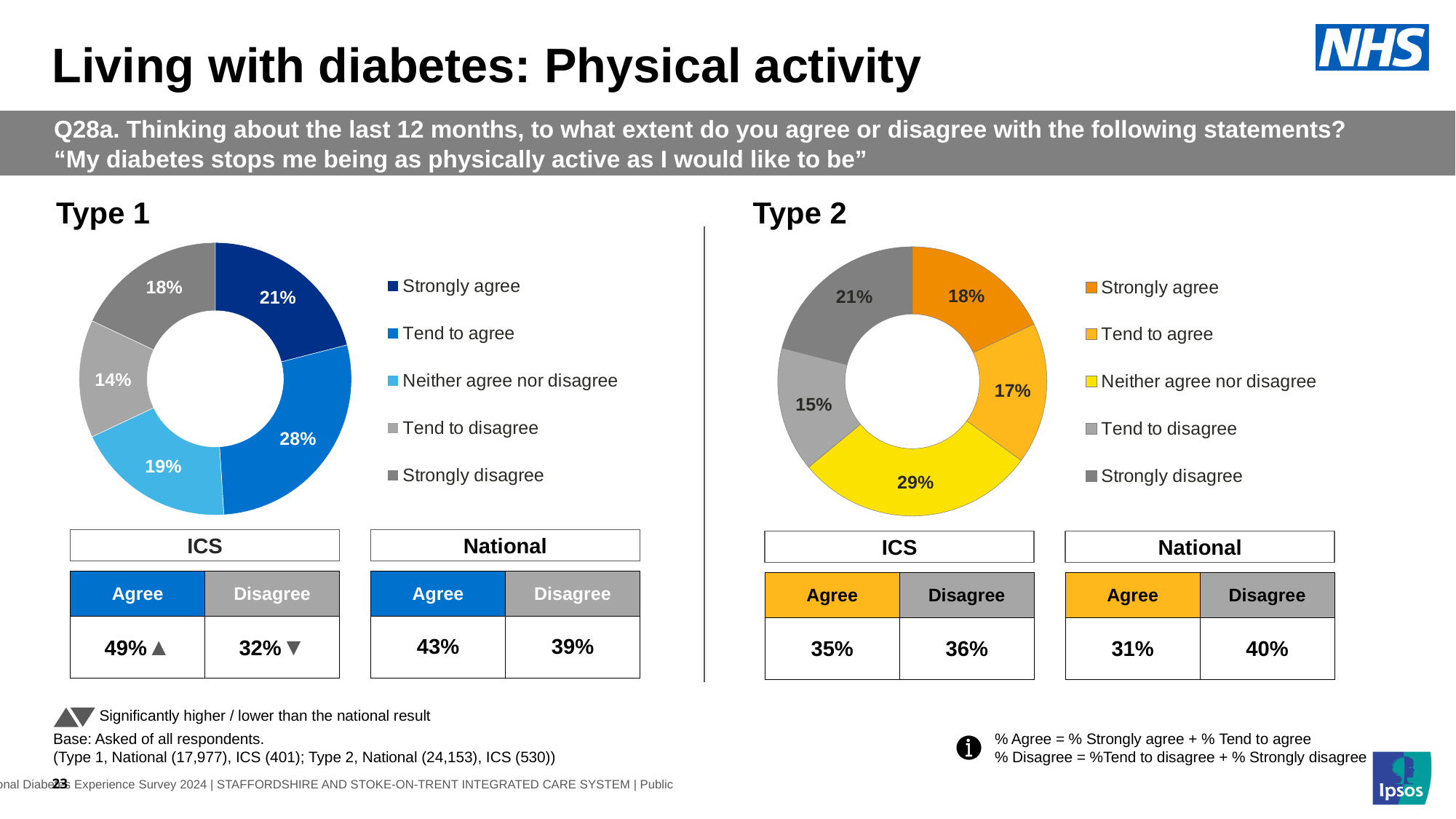
In the Type 1 chart, what is the difference in percentage points between 'Tend to agree' and 'Strongly agree'? 7 In the Type 2 chart, what is the combined share of 'Strongly agree' and 'Tend to agree'? 35% In the Type 1 chart, what colour represents 'Strongly agree'? Dark blue What type of chart is used for the Type 2 data? Doughnut (pie) chart In the Type 2 chart, which response category has the smallest share? Tend to disagree In the Type 2 chart, what percentage of respondents said 'Neither agree nor disagree'? 29% How many response categories are shown in the Type 1 chart? 5 In the Type 2 chart, which is larger: 'Strongly disagree' or 'Tend to agree'? Strongly disagree In the Type 2 chart, what percentage of respondents said 'Strongly agree'? 18% In the Type 1 chart, what percentage of respondents said 'Tend to agree'? 28% In the Type 1 chart, which response category has the largest share? Tend to agree In the Type 1 chart, what percentage of respondents said 'Tend to disagree'? 14%